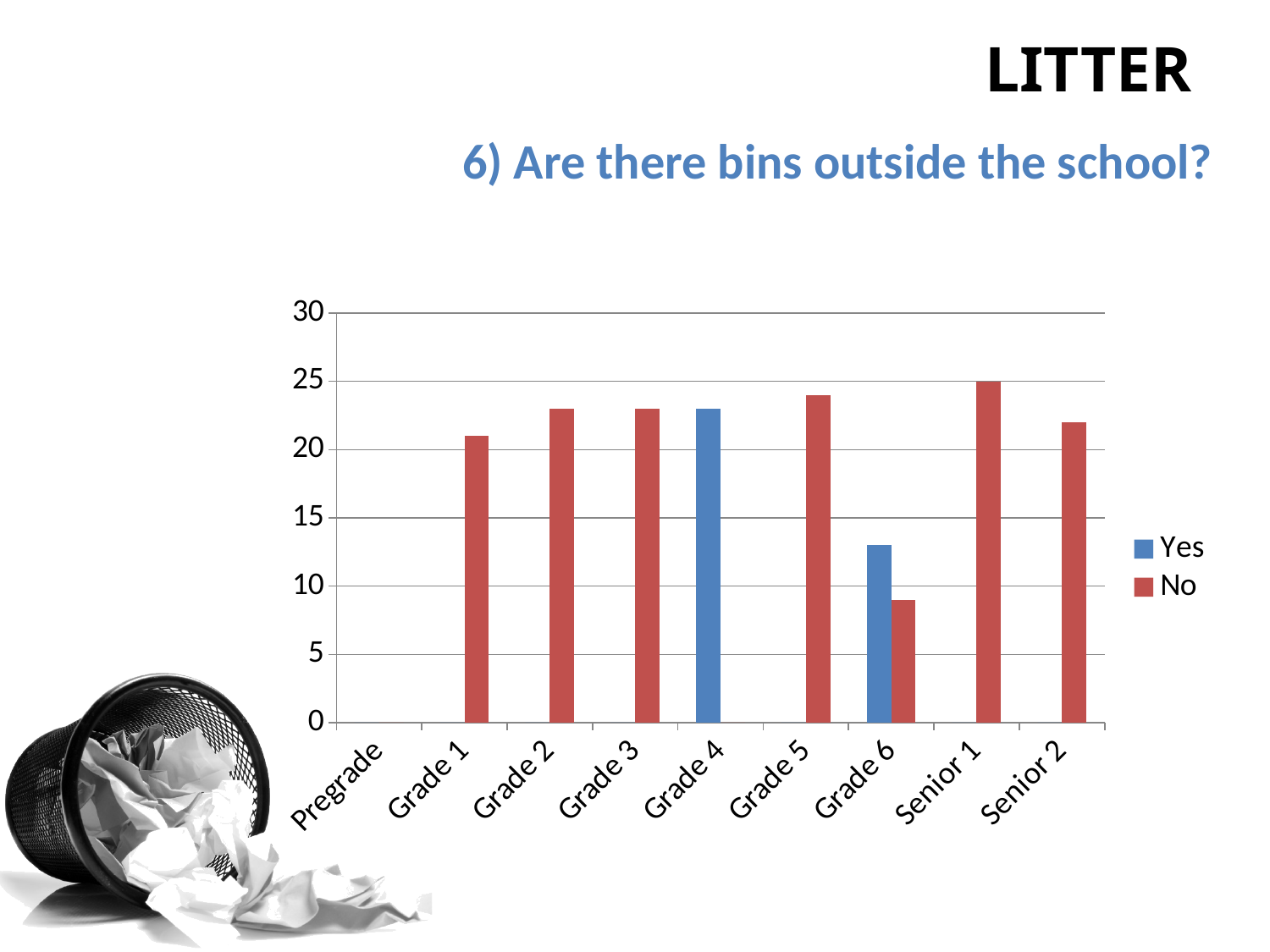
What kind of chart is shown on the slide? bar chart How many categories are shown on the x axis? 9 Is the No value for Grade 1 greater or less than 20? greater How many series does the legend list? 2 For Grade 6, which is larger, the Yes bar or the No bar? Yes Is the Yes value for Grade 4 greater or less than 20? greater What is the value of the No bar for Senior 1? 25 Which category has the lowest non-zero bar in the chart? Grade 6 Is the No value for Grade 6 greater or less than 10? less Which colour represents the No series in the legend? red Which category shows no bars at all? Pregrade